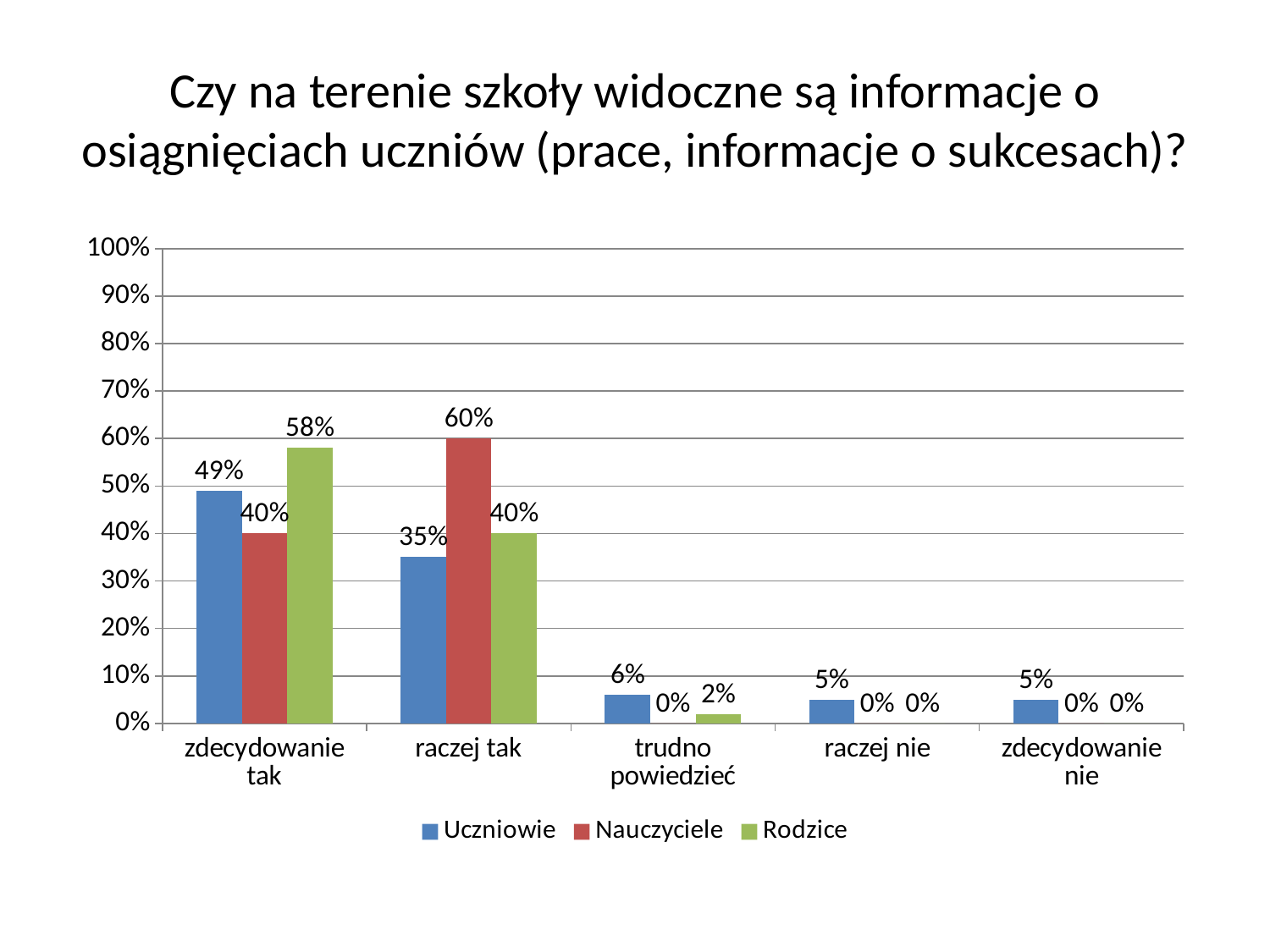
Is the value for Nauczyciele in "raczej tak" greater or less than 50%? greater What is the value for Nauczyciele in the "raczej tak" category? 60% What is the difference between the Rodzice and Nauczyciele values in the "zdecydowanie tak" category? 18% Which series is shown in green in the legend? Rodzice What is the value for Uczniowie in the "zdecydowanie tak" category? 49% How many categories are shown on the x axis? 5 Which category has the highest value for Nauczyciele? raczej tak What kind of chart is shown on the slide? bar chart How many series does the legend list? 3 Which category has the highest value for Rodzice? zdecydowanie tak What is the value for Rodzice in the "trudno powiedzieć" category? 2% Which is larger in the "raczej tak" category: Uczniowie or Rodzice? Rodzice